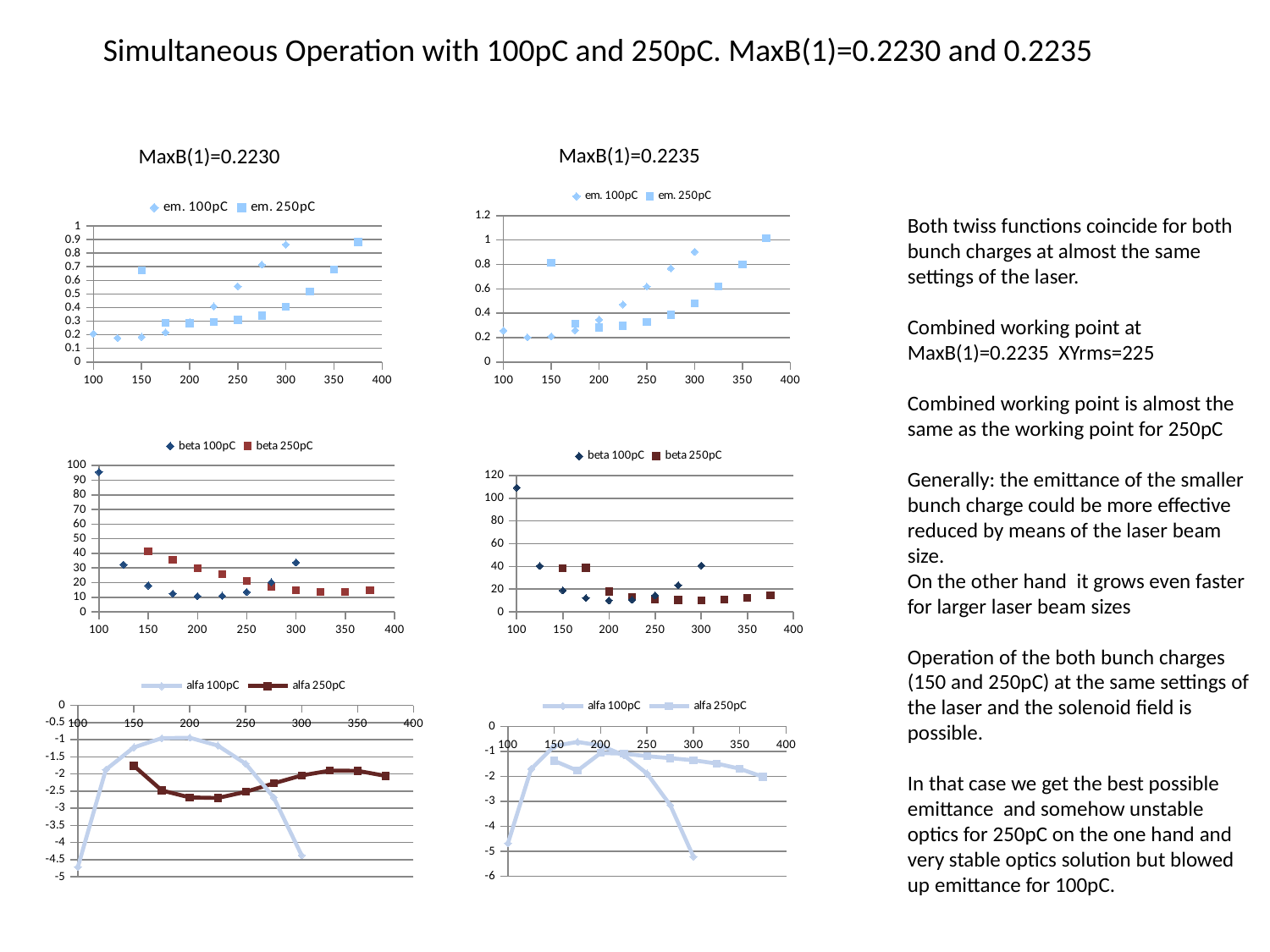
In the top-left emittance chart (under MaxB(1)=0.2230), is the em. 100pC value at x=300 greater or less than 0.8? greater In the top-left emittance chart (under MaxB(1)=0.2230), what are the two legend entries? em. 100pC and em. 250pC In the middle-right beta chart (under MaxB(1)=0.2235), is the beta 100pC value at x=100 greater or less than 100? greater In the top-left emittance chart (under MaxB(1)=0.2230), how many series does the legend list? 2 In the bottom-left alfa chart (under MaxB(1)=0.2230), is the alfa 100pC value at x=100 greater or less than -4? less In the middle-left beta chart (under MaxB(1)=0.2230), which is larger at x=150: beta 100pC or beta 250pC? beta 250pC What kind of chart is the bottom-right alfa chart (under MaxB(1)=0.2235)? line chart In the middle-left beta chart (under MaxB(1)=0.2230), at which x value does beta 100pC reach its highest point? 100 In the top-left emittance chart (under MaxB(1)=0.2230), which is larger at x=150: em. 100pC or em. 250pC? em. 250pC